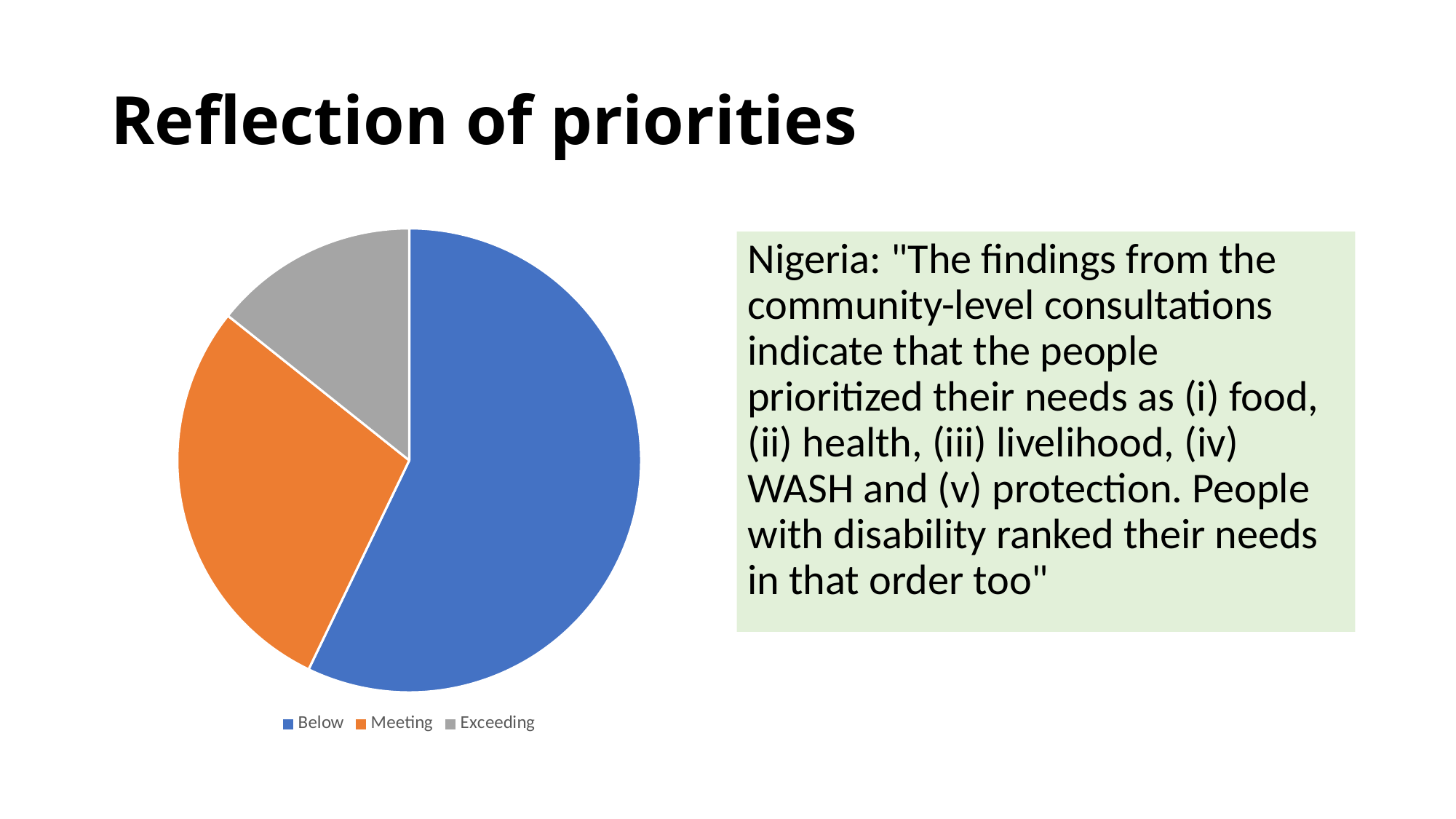
What colour is the Meeting slice of the pie chart? orange What kind of chart is shown on the slide? pie chart Which slice is larger, Meeting or Exceeding? Meeting What are the three categories listed in the pie chart's legend? Below, Meeting, Exceeding Which category has the smallest slice of the pie chart? Exceeding How many slices does the pie chart have? 3 Which category has the largest slice of the pie chart? Below Which slice is larger, Below or Meeting? Below